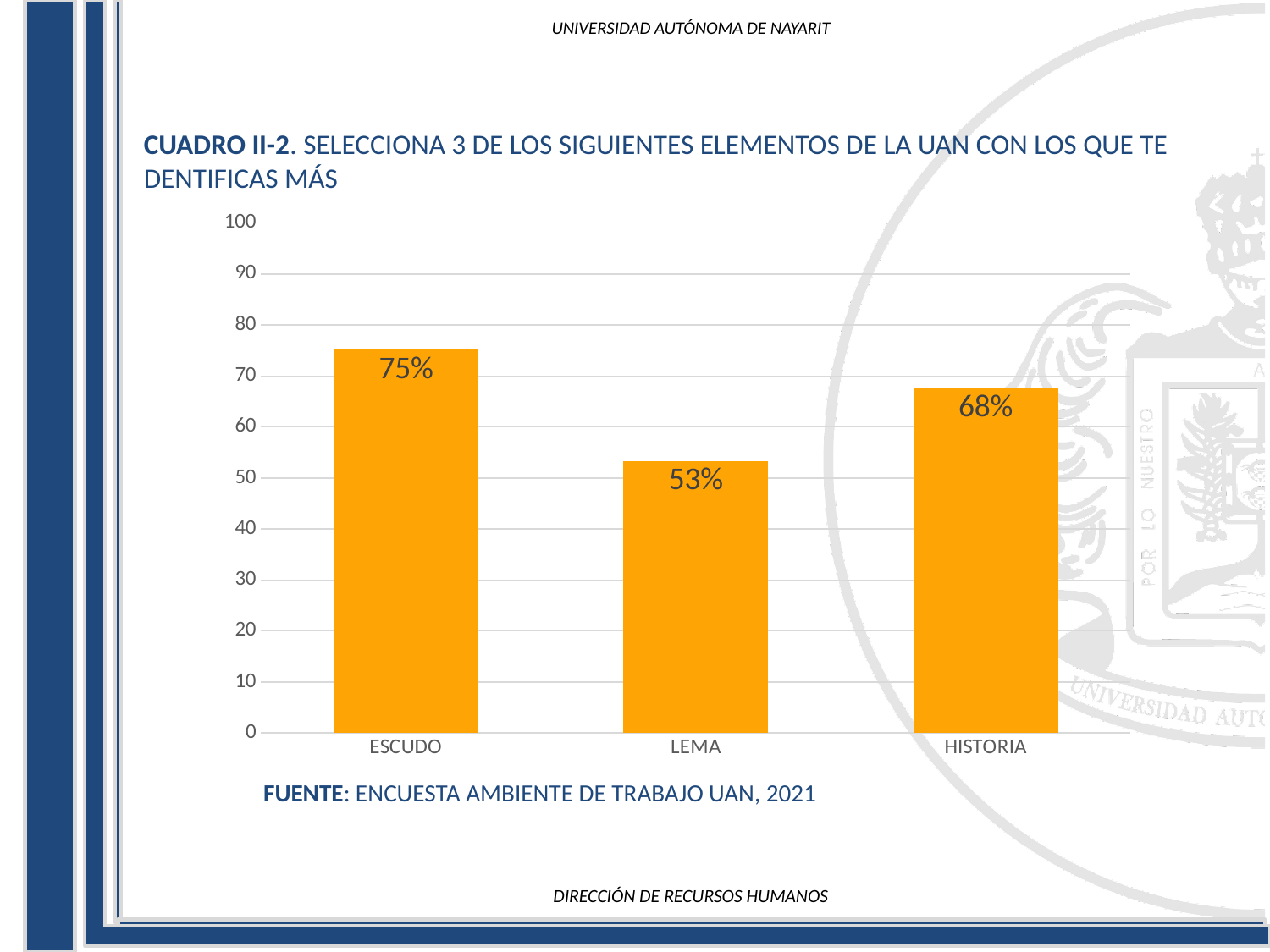
What kind of chart is shown on the slide? bar chart What is the value for HISTORIA? 68% What is the difference between the values for ESCUDO and LEMA? 22% How many categories are shown on the x axis? 3 What source is cited below the chart? ENCUESTA AMBIENTE DE TRABAJO UAN, 2021 What is the difference between the values for HISTORIA and LEMA? 15% Is the value for LEMA greater or less than 60? less What is the value for ESCUDO? 75% What is the value for LEMA? 53% Which category has the lowest value? LEMA Which is larger, the value for HISTORIA or the value for LEMA? HISTORIA Which category has the highest value? ESCUDO